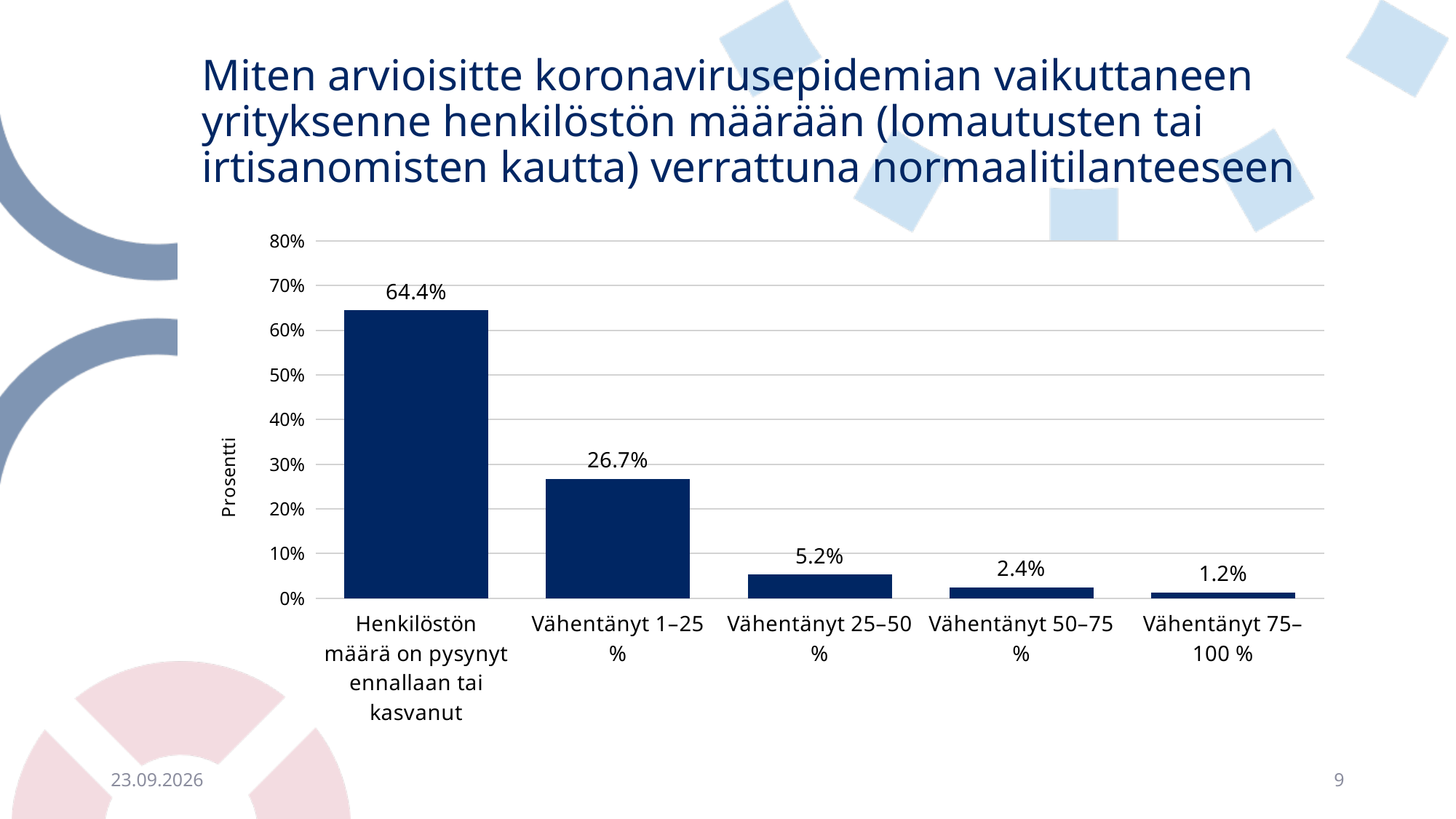
What is the value for "Vähentänyt 75–100 %"? 1.2% Which category has the lowest value? Vähentänyt 75–100 % What is the difference between the values for "Henkilöstön määrä on pysynyt ennallaan tai kasvanut" and "Vähentänyt 1–25 %"? 37.7% Which is larger, the value for "Vähentänyt 25–50 %" or "Vähentänyt 50–75 %"? Vähentänyt 25–50 % What is the label of the vertical axis? Prosentti What kind of chart is shown on the slide? bar chart Which category has the highest value? Henkilöstön määrä on pysynyt ennallaan tai kasvanut How many categories are shown on the x axis? 5 What is the value for "Henkilöstön määrä on pysynyt ennallaan tai kasvanut"? 64.4% What is the value for "Vähentänyt 25–50 %"? 5.2% Is the value for "Vähentänyt 1–25 %" greater or less than 30%? less What is the value for "Vähentänyt 1–25 %"? 26.7%